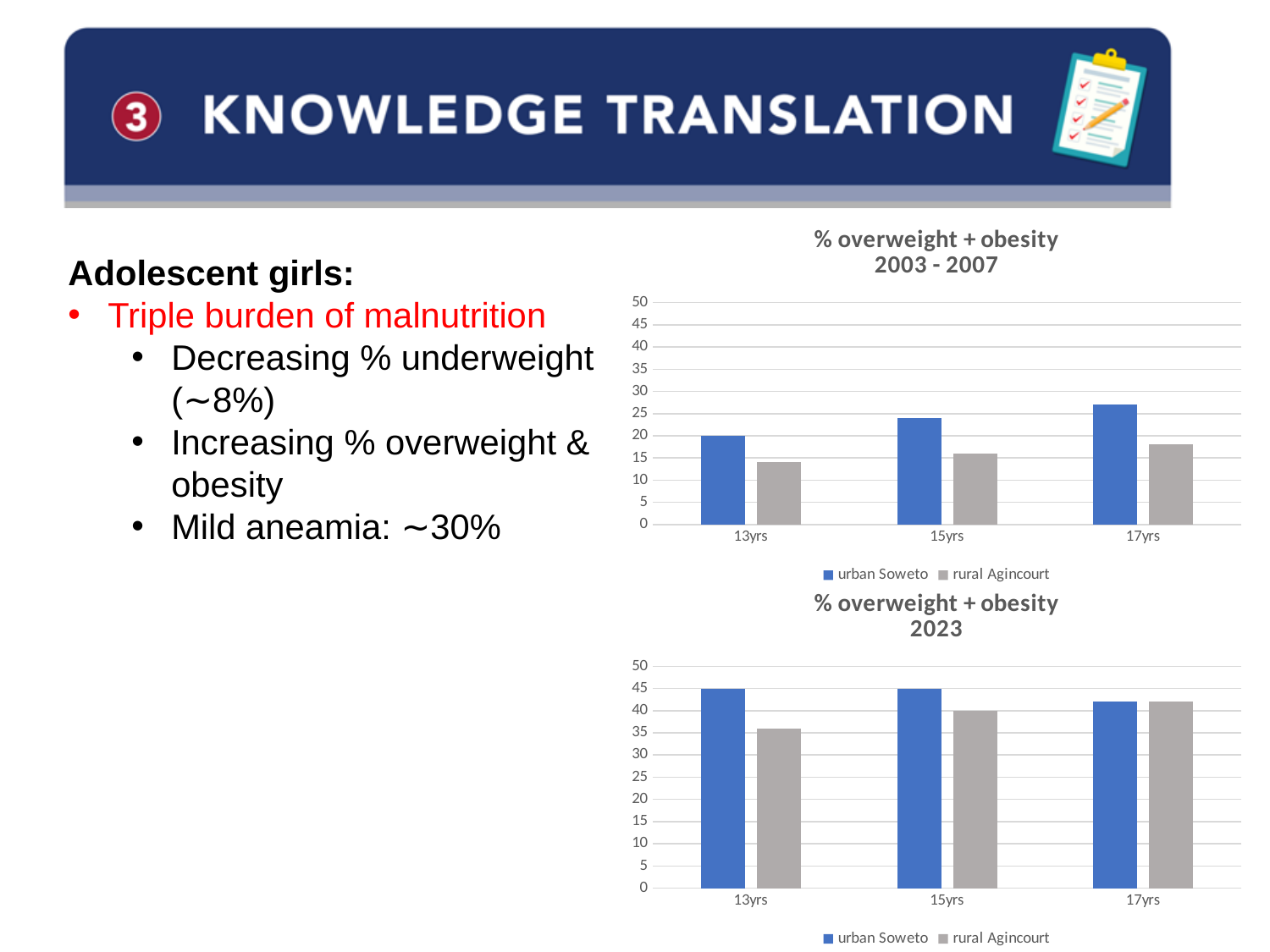
In the '% overweight + obesity 2003 - 2007' chart, do the urban Soweto values rise or fall from 13yrs to 17yrs? rise In the '% overweight + obesity 2023' chart, which age group has the lowest value for rural Agincourt? 13yrs In the '% overweight + obesity 2003 - 2007' chart, which age group has the lowest value for rural Agincourt? 13yrs In the '% overweight + obesity 2003 - 2007' chart, which age group has the highest value for urban Soweto? 17yrs Which series is shown in blue in the '% overweight + obesity 2023' chart? urban Soweto What type of chart is the '% overweight + obesity 2003 - 2007' chart? bar chart In the '% overweight + obesity 2003 - 2007' chart, is the value for rural Agincourt at 13yrs greater or less than 15? less How many series does the legend list in the '% overweight + obesity 2023' chart? 2 In the '% overweight + obesity 2003 - 2007' chart, is the value for urban Soweto at 17yrs greater or less than 25? greater In the '% overweight + obesity 2023' chart, is the value for rural Agincourt at 13yrs greater or less than 40? less How many age categories are shown on the x axis of the '% overweight + obesity 2003 - 2007' chart? 3 In the '% overweight + obesity 2023' chart, which is larger at 15yrs: urban Soweto or rural Agincourt? urban Soweto